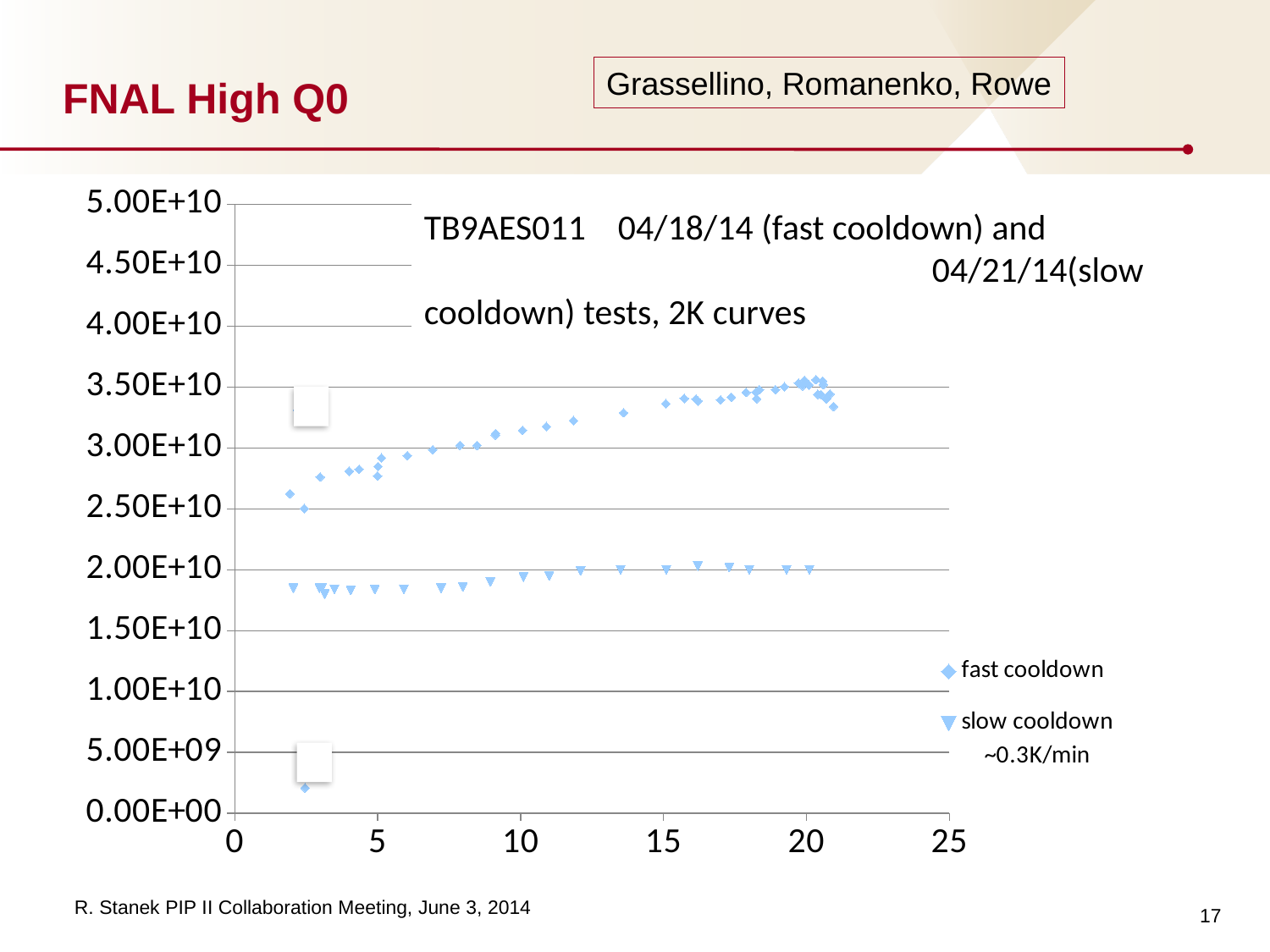
What are the two series named in the chart legend? fast cooldown and slow cooldown ~0.3K/min How many series does the chart legend list? 2 At x = 10, which series has the higher value, fast cooldown or slow cooldown? fast cooldown What is the highest value shown on the y axis? 5.00E+10 Do the fast cooldown values generally rise or fall as x increases from 2 to 20? rise Is the highest fast cooldown value greater or less than 4.00E+10? less Is the fast cooldown value at x = 15 greater or less than 3.00E+10? greater Is the slow cooldown value at x = 15 greater or less than 2.50E+10? less What cavity name appears at the start of the chart title? TB9AES011 Which series has the higher values overall, fast cooldown or slow cooldown? fast cooldown What kind of chart is shown on the slide? scatter chart